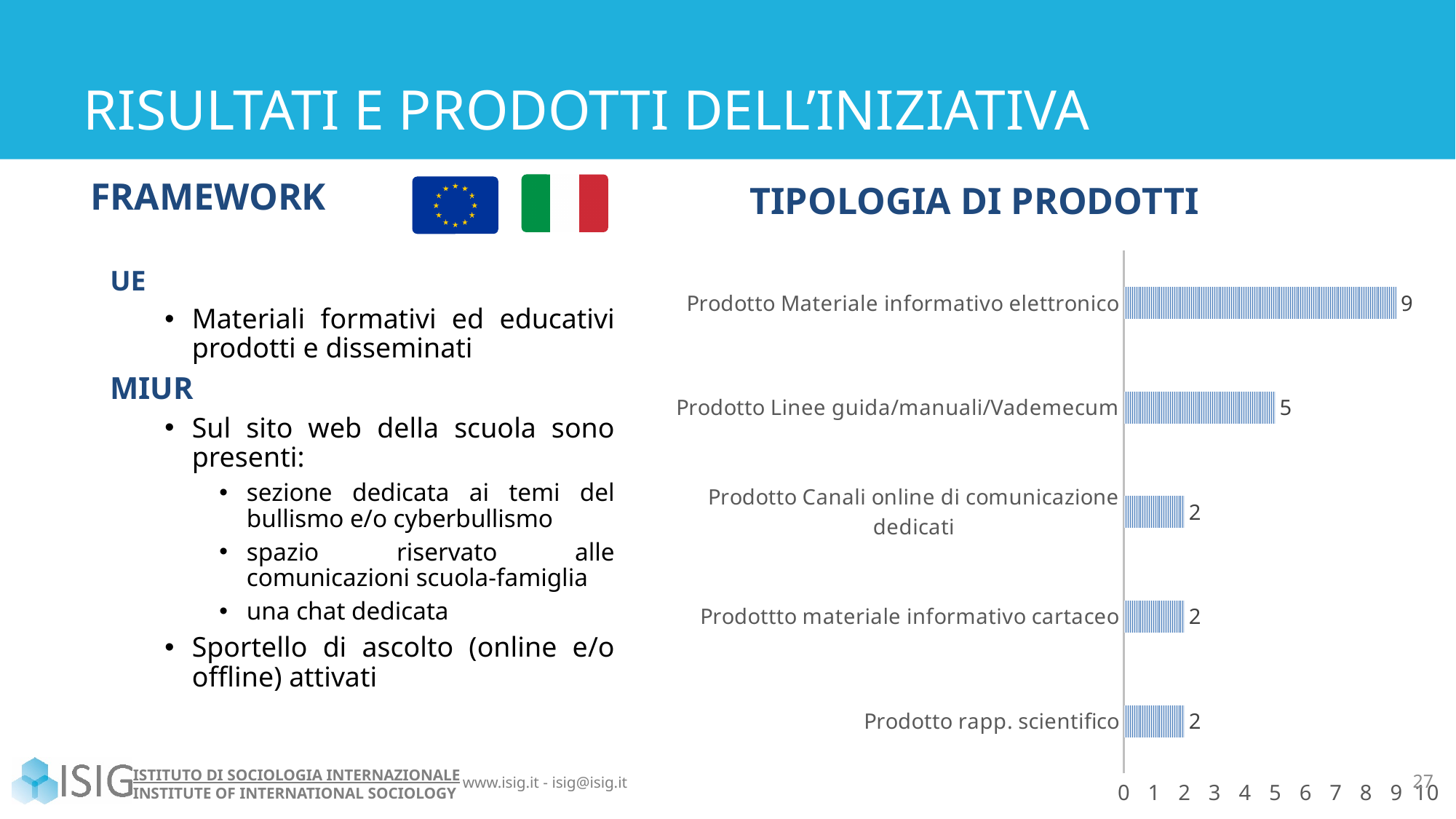
What is the value for Prodotto Linee guida/manuali/Vademecum? 5 Which is larger: the value for Prodotto Linee guida/manuali/Vademecum or the value for Prodottto materiale informativo cartaceo? Prodotto Linee guida/manuali/Vademecum Is the value for Prodotto Materiale informativo elettronico greater or less than 8? greater What kind of chart is shown on the slide? bar chart What is the difference between the values for Prodotto Materiale informativo elettronico and Prodotto Linee guida/manuali/Vademecum? 4 Which category has the highest value? Prodotto Materiale informativo elettronico What is the title of the chart? TIPOLOGIA DI PRODOTTI What is the value for Prodotto Materiale informativo elettronico? 9 How many categories have a value of 2? 3 How many categories are shown in the chart? 5 What is the maximum value shown on the horizontal axis? 10 What is the value for Prodotto rapp. scientifico? 2